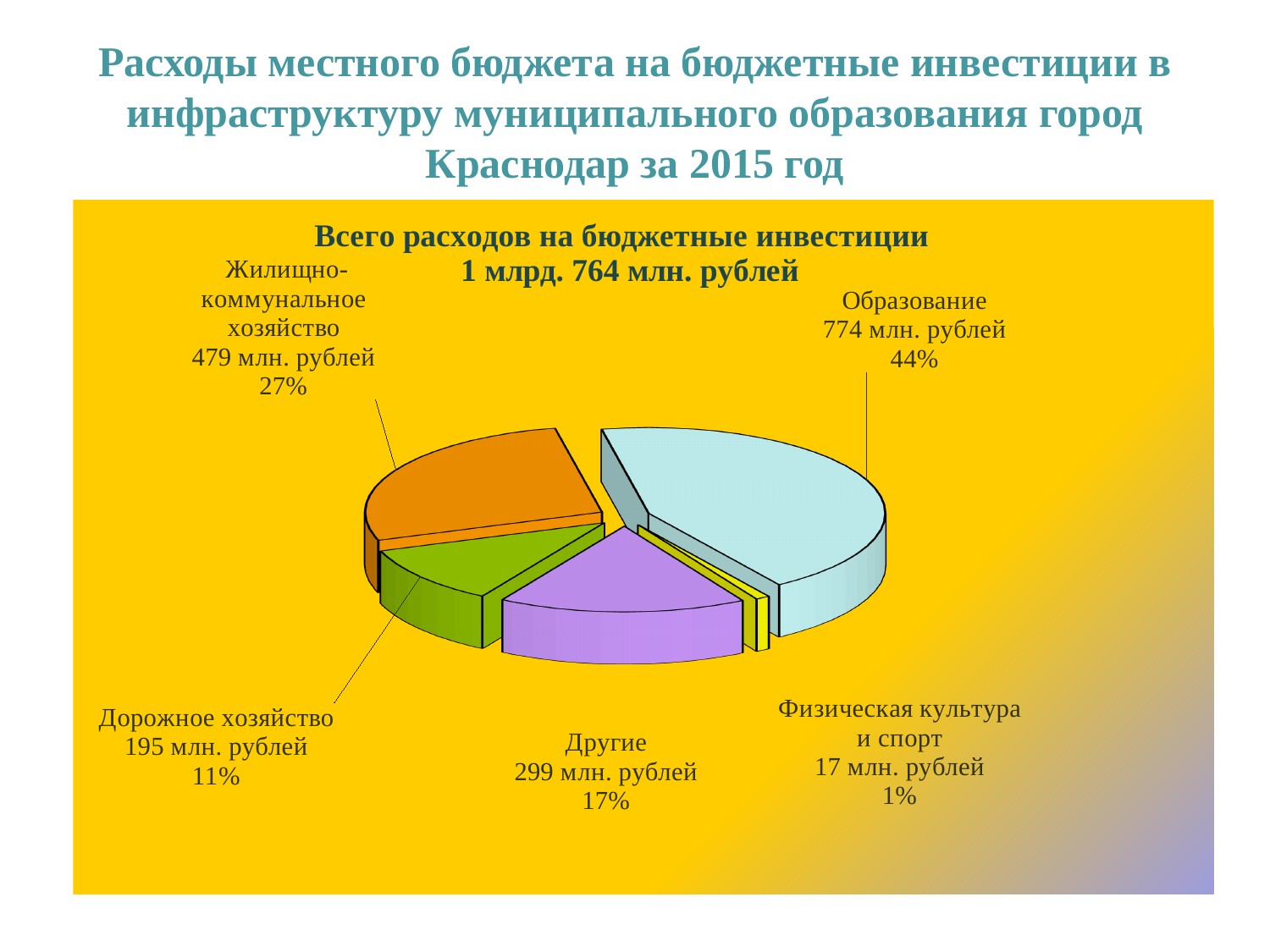
What type of chart is shown on the slide? Pie chart What share of the pie does Другие represent? 17% How many slices does the pie chart have? 5 What is the difference in value between Образование and Жилищно-коммунальное хозяйство? 295 млн. рублей Which category has the smallest slice of the pie? Физическая культура и спорт What share of the pie does Жилищно-коммунальное хозяйство represent? 27% Which category has the largest slice of the pie? Образование Which is larger, the value for Другие or the value for Дорожное хозяйство? Другие What is the value for Образование? 774 млн. рублей What share of the pie does Физическая культура и спорт represent? 1% What is the value for Дорожное хозяйство? 195 млн. рублей What total expenditure on budget investments is stated in the chart title? 1 млрд. 764 млн. рублей